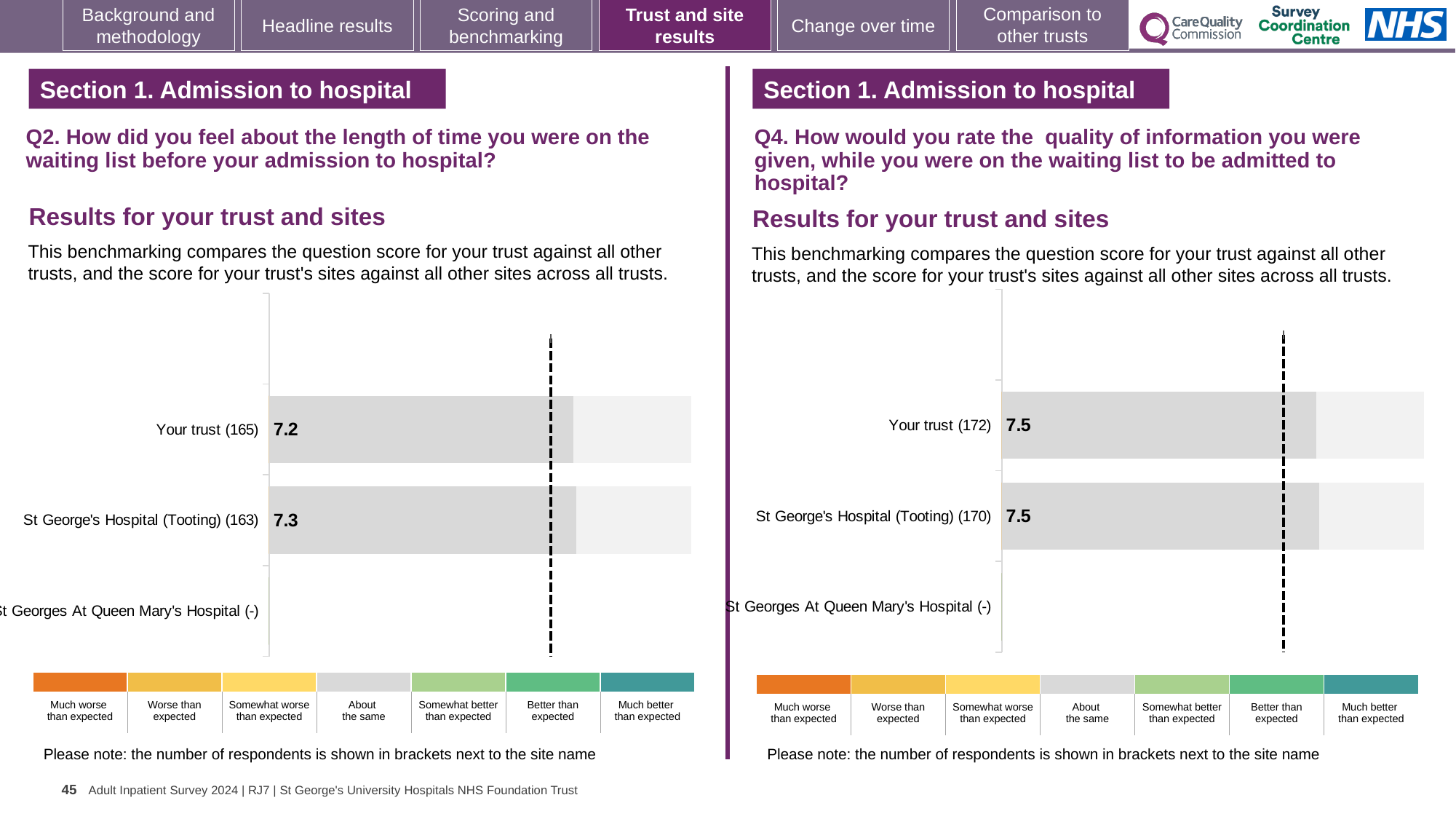
On the Q2 chart (left), what is the score for Your trust? 7.2 On the Q2 chart (left), how many respondents are shown in brackets for Your trust? 165 On the Q4 chart (right), what is the score for Your trust? 7.5 On the Q2 chart (left), which category has no score shown? St Georges At Queen Mary's Hospital (-) On the Q4 chart (right), how many respondents are shown in brackets for St George's Hospital (Tooting)? 170 What kind of chart is used on the Q4 chart (right)? Bar chart On the Q2 chart (left), what is the difference between the score for St George's Hospital (Tooting) and the score for Your trust? 0.1 On the Q4 chart (right), what is the score for St George's Hospital (Tooting)? 7.5 On the Q4 chart (right), how many respondents are shown in brackets for Your trust? 172 On the Q2 chart (left), how many site/trust categories are listed on the vertical axis? 3 On the Q4 chart (right), how many categories does the colour key below the chart list? 7 On the Q2 chart (left), what is the score for St George's Hospital (Tooting)? 7.3